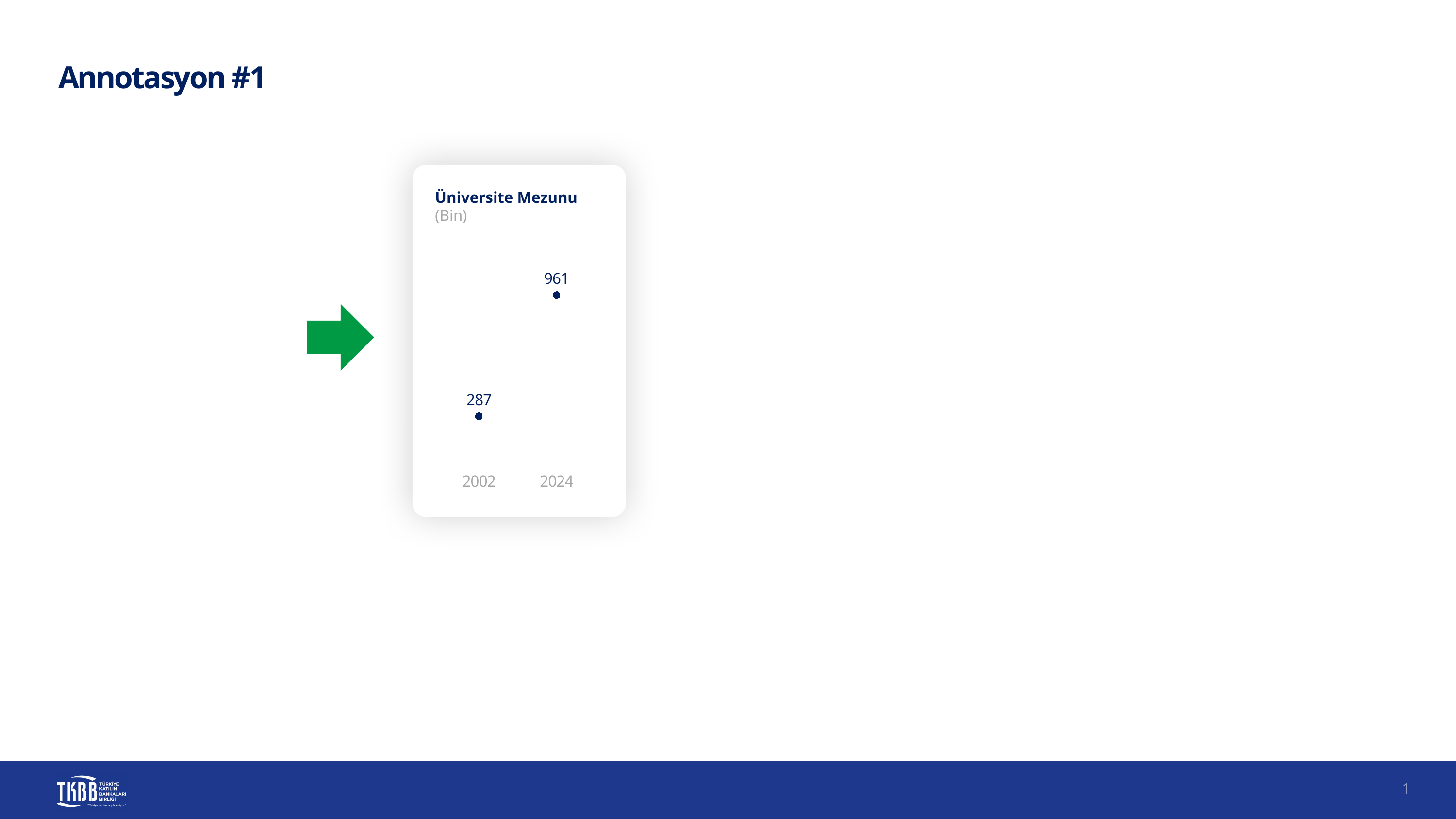
Which year has the lower value in the Üniversite Mezunu chart? 2002 What is the title of the chart on the slide? Üniversite Mezunu What is the difference between the 2024 and 2002 values in the Üniversite Mezunu chart? 674 What is the value for 2002 in the Üniversite Mezunu chart? 287 Do the values rise or fall from 2002 to 2024 in the Üniversite Mezunu chart? rise How many data points are plotted in the Üniversite Mezunu chart? 2 Is the value for 2024 larger or smaller than the value for 2002 in the Üniversite Mezunu chart? larger Which year has the higher value in the Üniversite Mezunu chart? 2024 What is the value for 2024 in the Üniversite Mezunu chart? 961 What unit is shown under the title of the Üniversite Mezunu chart? (Bin)